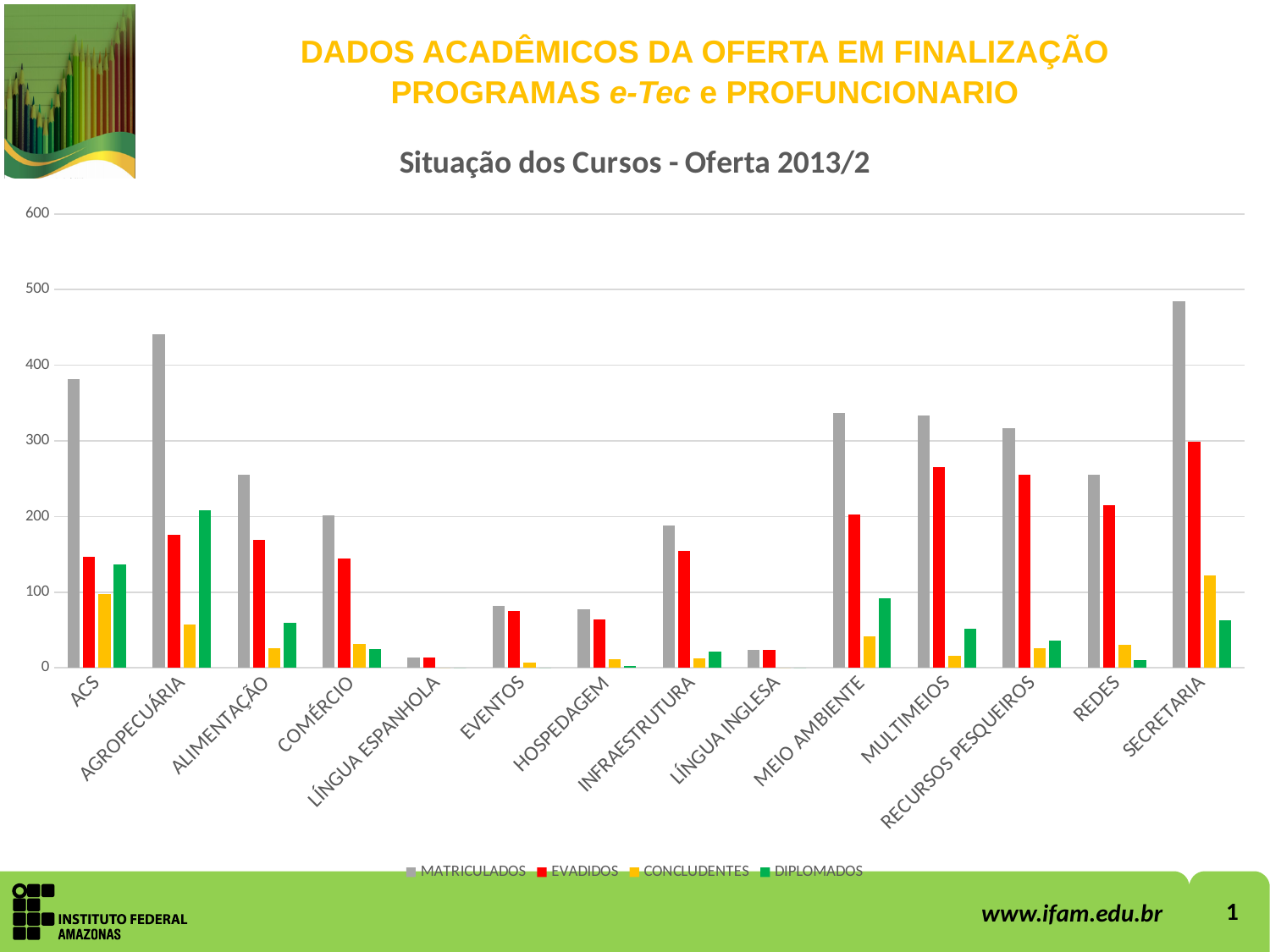
Is the DIPLOMADOS value for MEIO AMBIENTE greater or less than 100? less How many series does the chart legend list? 4 Is the EVADIDOS value for ALIMENTAÇÃO greater or less than 100? greater Which course has the highest DIPLOMADOS value? AGROPECUÁRIA Which course has the highest EVADIDOS value? SECRETARIA Which course has the highest MATRICULADOS value? SECRETARIA What is the title of the chart? Situação dos Cursos - Oferta 2013/2 What kind of chart is shown on the slide? Bar chart Which course has the lowest MATRICULADOS value? LÍNGUA ESPANHOLA Is the MATRICULADOS value for ACS greater or less than 300? greater How many courses (categories) are shown on the x axis of the chart? 14 Which has the larger MATRICULADOS value, AGROPECUÁRIA or ALIMENTAÇÃO? AGROPECUÁRIA